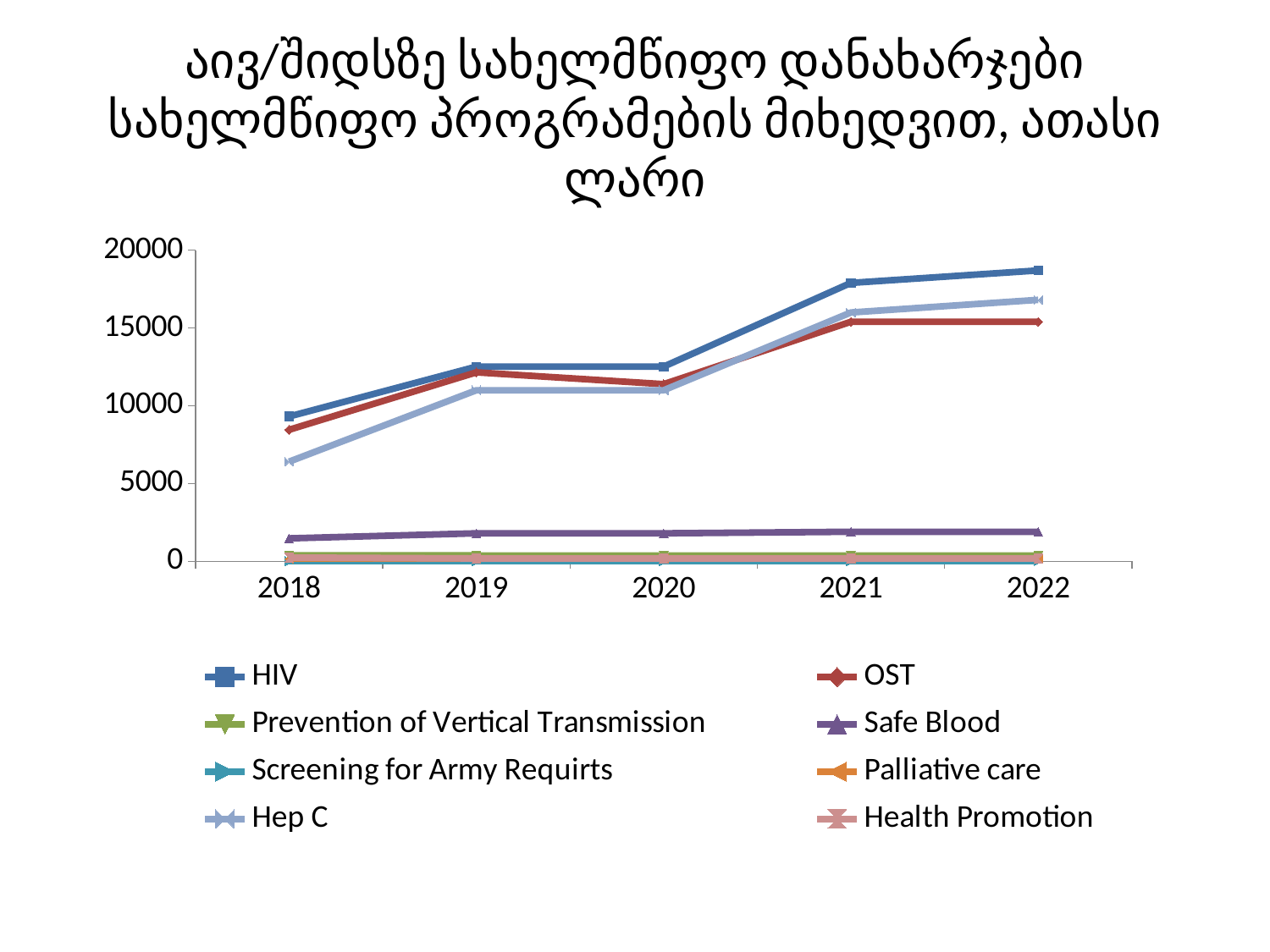
Does the HIV line rise or fall from 2018 to 2022? rises Which series has the highest value in 2022? HIV How many years are shown on the x axis? 5 Is the value for HIV in 2022 greater or less than 15000? greater Is the value for Hep C in 2018 greater or less than 5000? greater Which series is shown with a red line and diamond markers? OST In which year is the HIV value highest? 2022 How many series does the legend list? 8 What kind of chart is shown on the slide? line chart Which is larger in 2018, the value for OST or the value for Hep C? OST Is the value for Safe Blood in 2022 greater or less than 5000? less